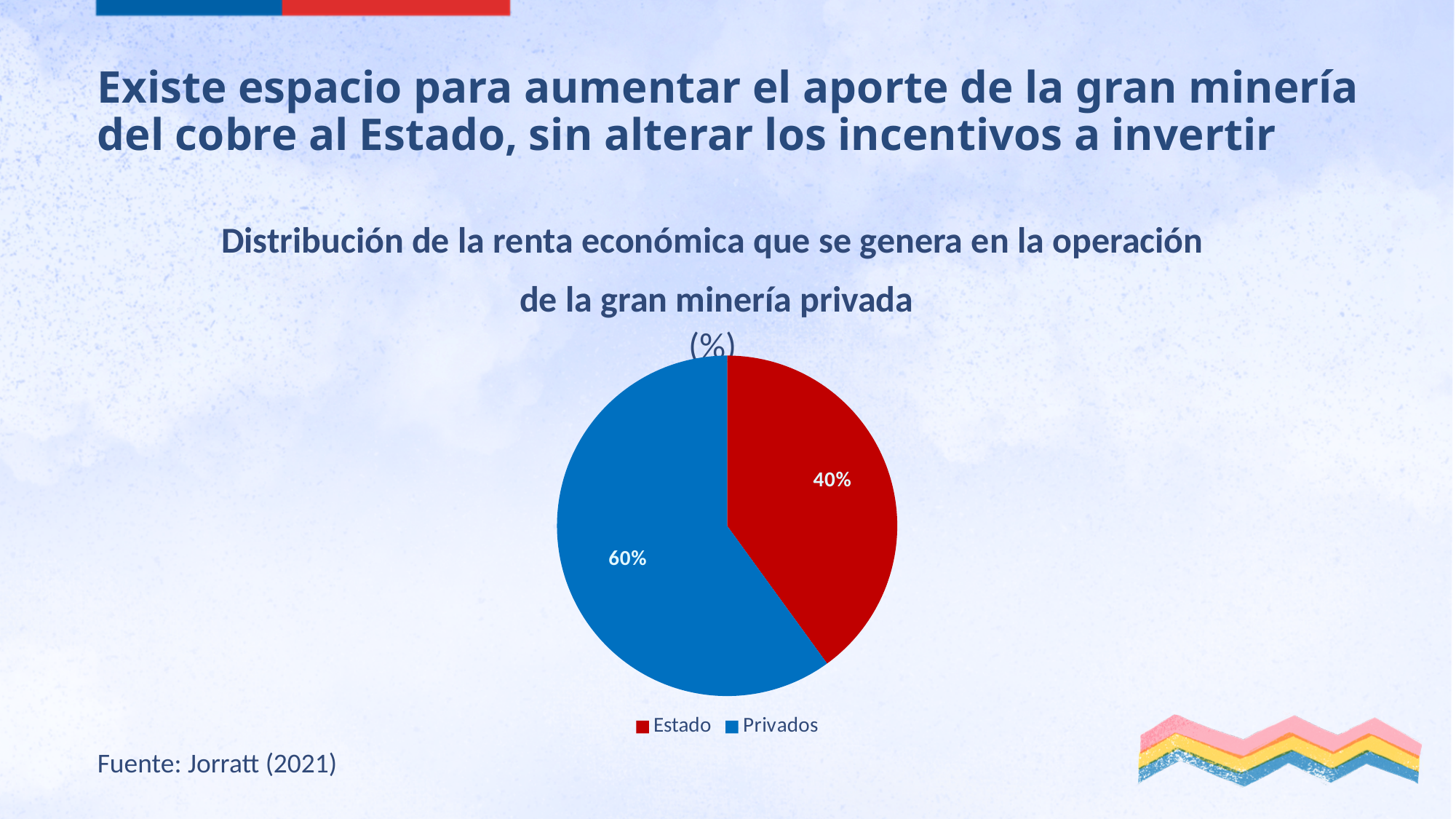
Which category has the largest share of the pie? Privados What share of the economic rent goes to Privados? 60% How many entries does the legend list? 2 What is the source cited for the chart? Jorratt (2021) What share of the economic rent goes to Estado? 40% How many slices does the pie chart have? 2 Which category has the smallest share of the pie? Estado Which is larger, the share for Estado or the share for Privados? Privados What kind of chart is shown on the slide? Pie chart What colour is the Estado slice? Red What is the difference in percentage points between the Privados and Estado shares? 20%